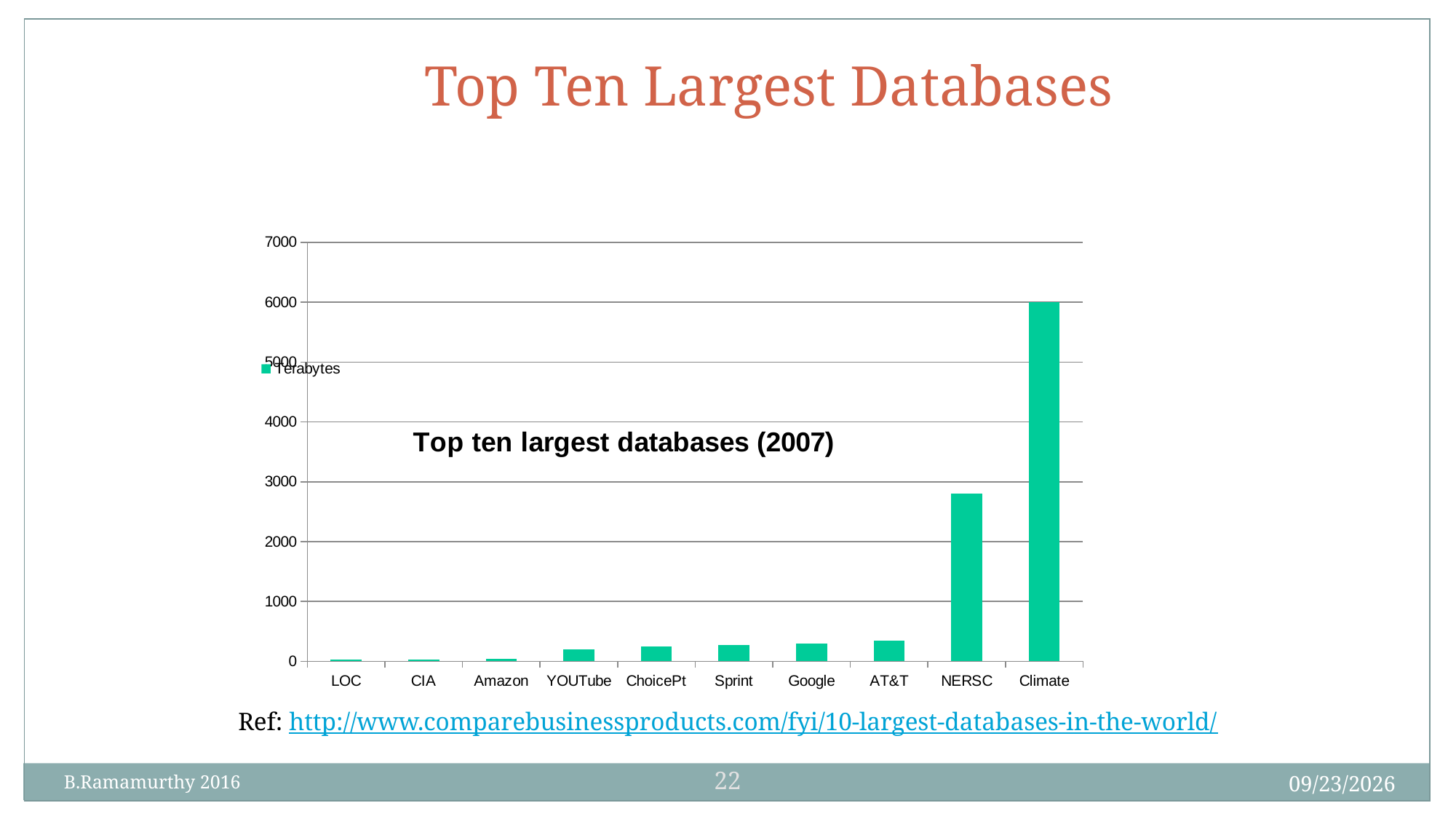
Which is larger, the value for NERSC or the value for AT&T? NERSC What is the series name shown in the chart legend? Terabytes Is the value for AT&T greater or less than 1000? less Do the values generally rise or fall moving from left to right along the x axis? rise Is the value for NERSC greater or less than 3000? less What kind of chart is shown on the slide? bar chart How many series does the chart legend list? 1 How many databases (categories) are plotted on the chart? 10 Which database has the highest value on the chart? Climate Is the value for NERSC greater or less than 2000? greater What is the value for Climate in terabytes? 6000 Which is larger, the value for Climate or the value for NERSC? Climate